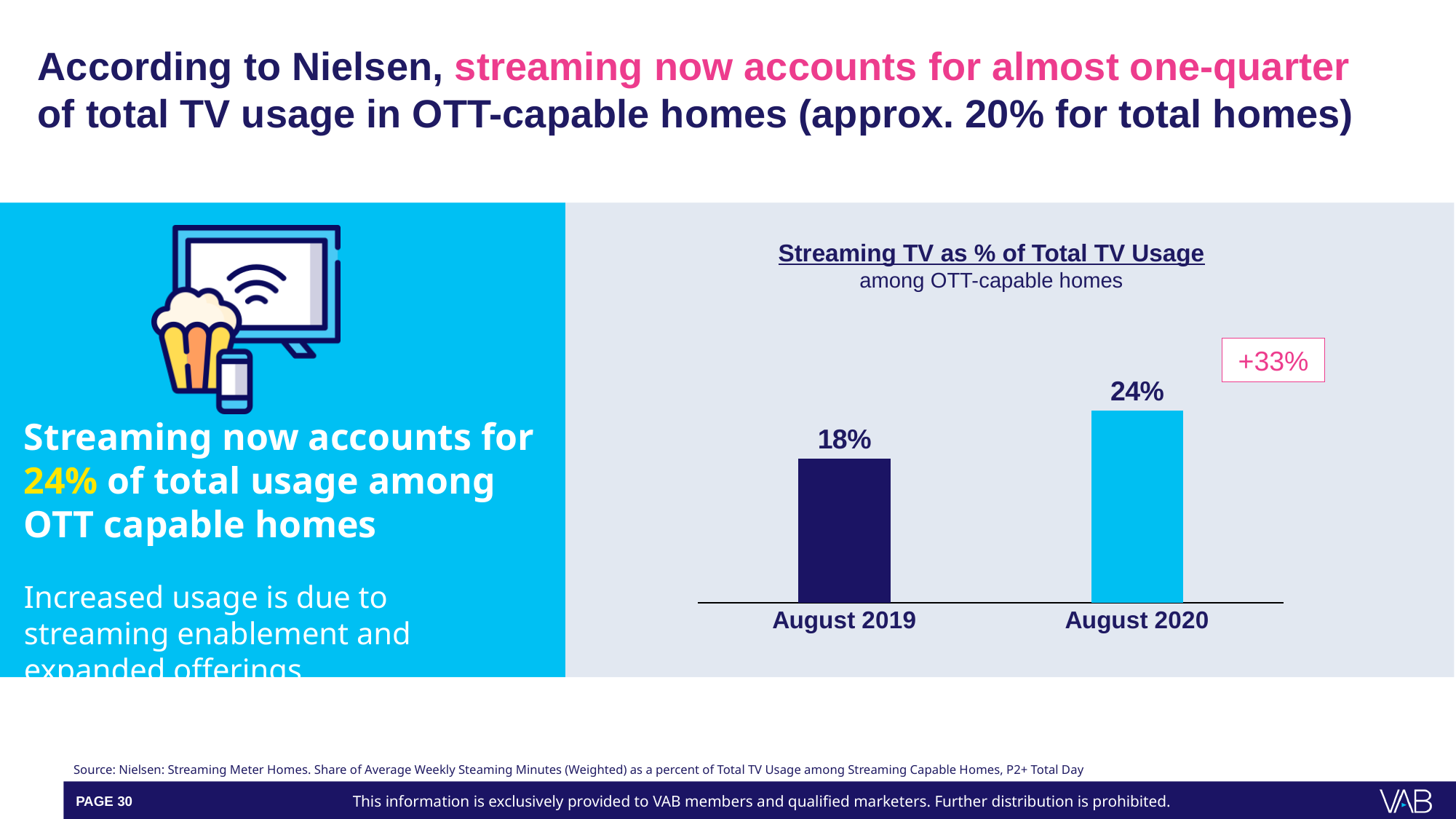
Which is larger, the value for August 2019 or August 2020? August 2020 What is the value for August 2020? 24% What kind of chart is shown on the slide? Bar chart What is the value for August 2019? 18% What is the title of the chart? Streaming TV as % of Total TV Usage What percentage change is annotated next to the August 2020 bar? +33% Do the values rise or fall from August 2019 to August 2020? Rise What is the difference between the August 2020 and August 2019 values? 6 percentage points Which category has the lowest value? August 2019 Which category has the highest value? August 2020 How many categories are shown on the x axis? 2